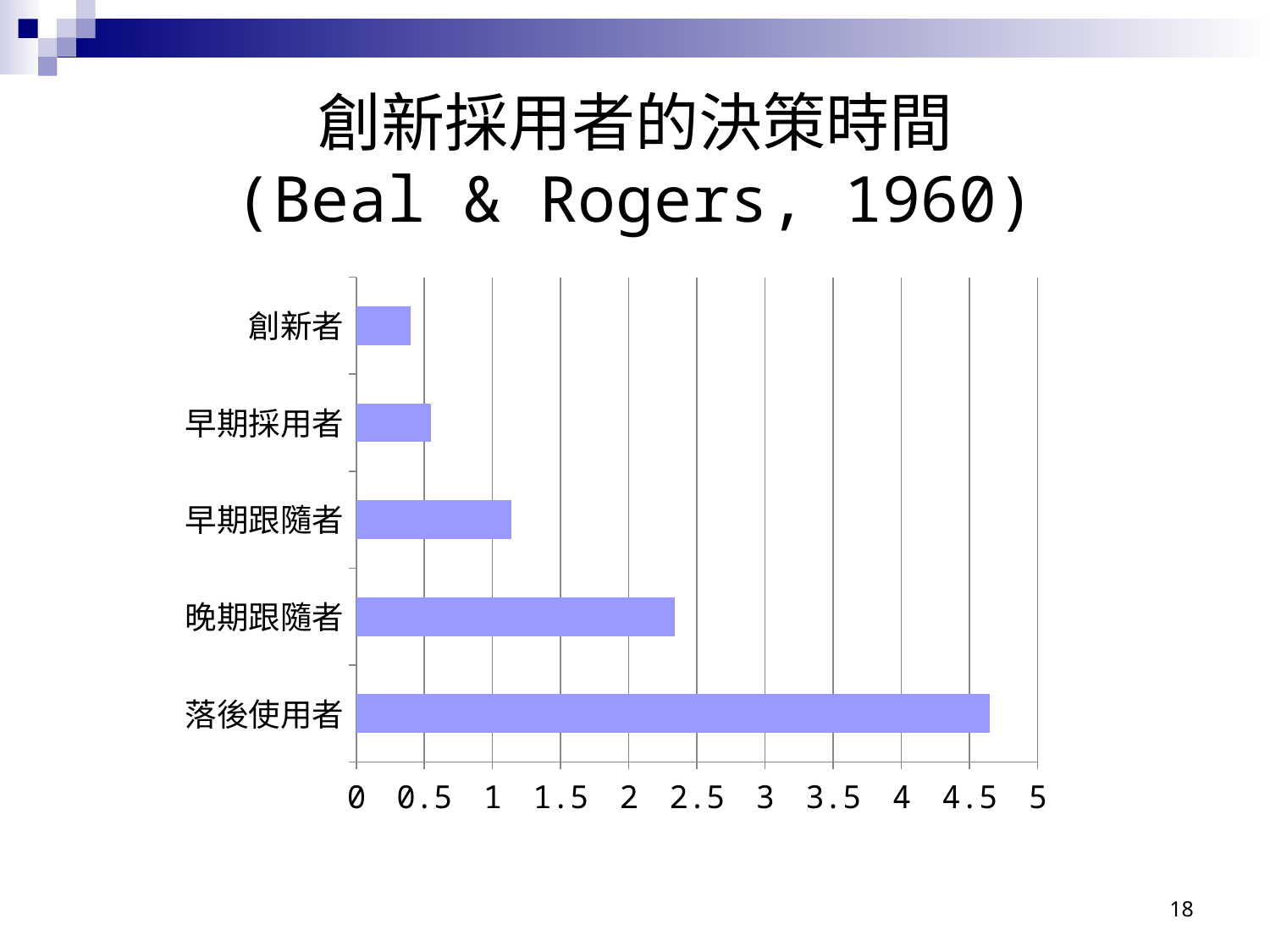
Which category has the highest value in the chart? 落後使用者 What kind of chart is shown on the slide? Bar chart How many categories are plotted in the chart? 5 Is the value for 早期跟隨者 greater or less than 1? greater Is the value for 晚期跟隨者 greater or less than 2.5? less Is the value for 落後使用者 greater or less than 4.5? greater Which has the larger value, 落後使用者 or 晚期跟隨者? 落後使用者 What is the title of the chart on the slide? 創新採用者的決策時間 (Beal & Rogers, 1960) Which category has the lowest value in the chart? 創新者 Which has the larger value, 早期跟隨者 or 早期採用者? 早期跟隨者